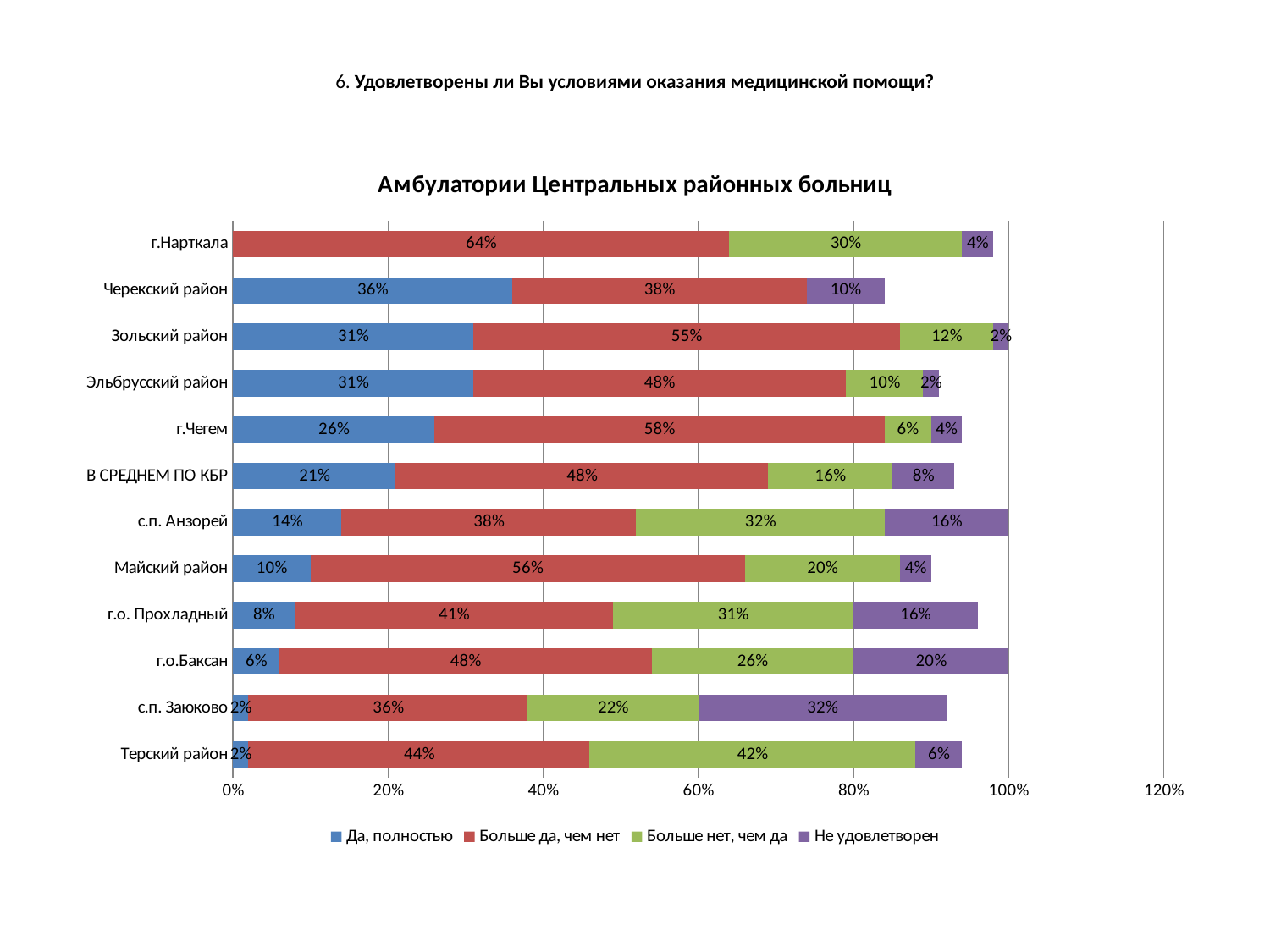
What type of chart is shown on the slide? stacked bar chart How many categories are plotted on the y axis? 12 What is the total of the stacked bar for Зольский район? 100% Which category has the highest value for 'Больше нет, чем да'? Терский район What is the value of 'Больше да, чем нет' for г.Нарткала? 64% What is the value of 'Не удовлетворен' for г.о.Баксан? 20% What is the difference between the 'Больше да, чем нет' values for г.Чегем and Майский район? 2% Which is larger: the 'Больше нет, чем да' value for с.п. Анзорей or for г.о. Прохладный? с.п. Анзорей How many series does the legend list? 4 Which category has the highest value for 'Не удовлетворен'? с.п. Заюково What is the value of 'Да, полностью' for В СРЕДНЕМ ПО КБР? 21% Which category has the highest value for 'Да, полностью'? Черекский район